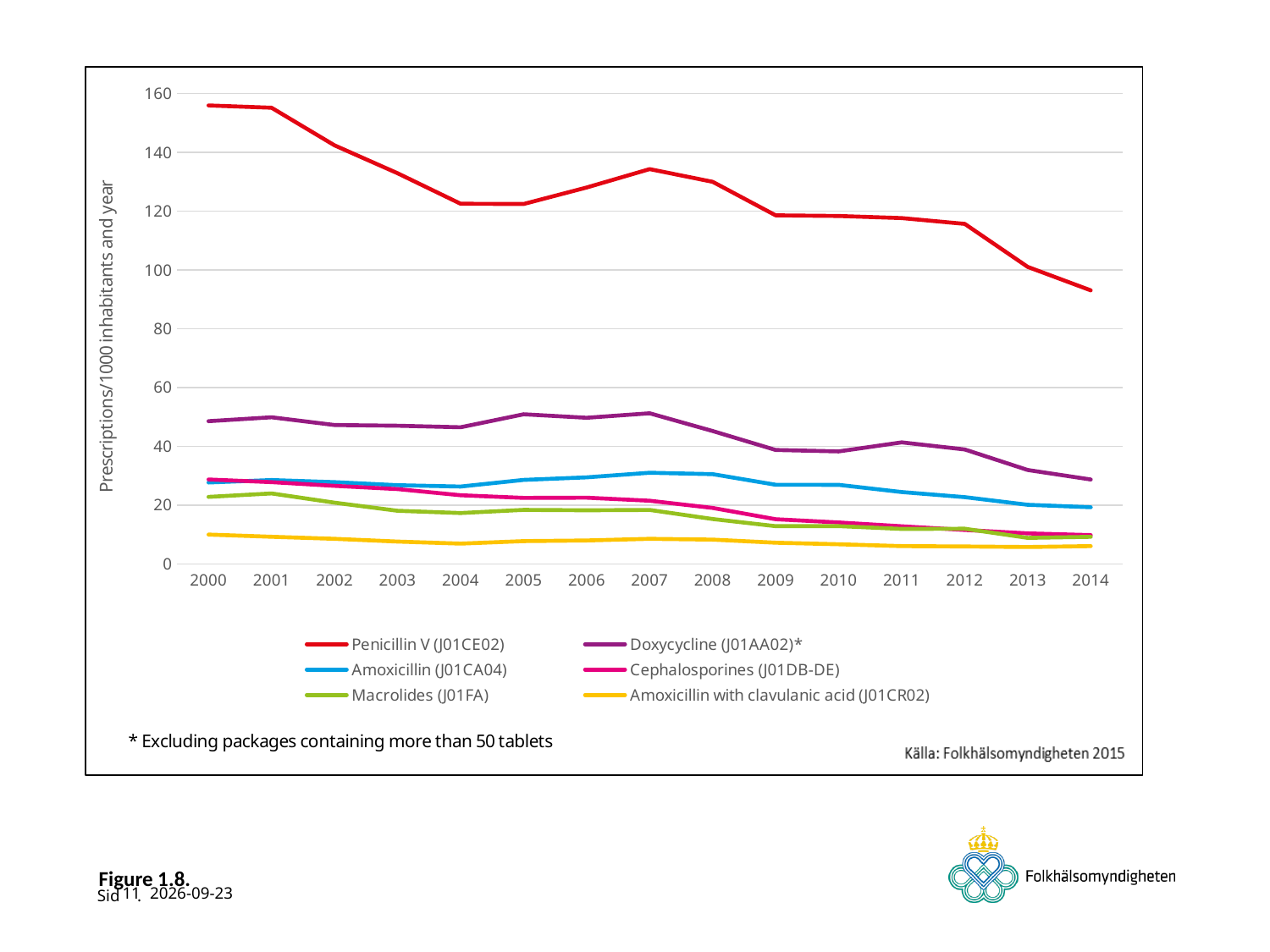
How many series does the legend list? 6 Is the value for Doxycycline (J01AA02)* in 2007 greater or less than 40? greater Is the value for Cephalosporines (J01DB-DE) in 2009 greater or less than 20? less Which series has the highest value in 2014? Penicillin V (J01CE02) What kind of chart is shown on the slide? line chart How many years are shown on the x axis? 15 In 2005, which is larger: Doxycycline (J01AA02)* or Amoxicillin (J01CA04)? Doxycycline (J01AA02)* Which series has the lowest value in 2000? Amoxicillin with clavulanic acid (J01CR02) Is the value for Penicillin V (J01CE02) in 2014 greater or less than 100? less Does the Penicillin V (J01CE02) line generally rise or fall from 2000 to 2014? fall What is the label of the y axis? Prescriptions/1000 inhabitants and year